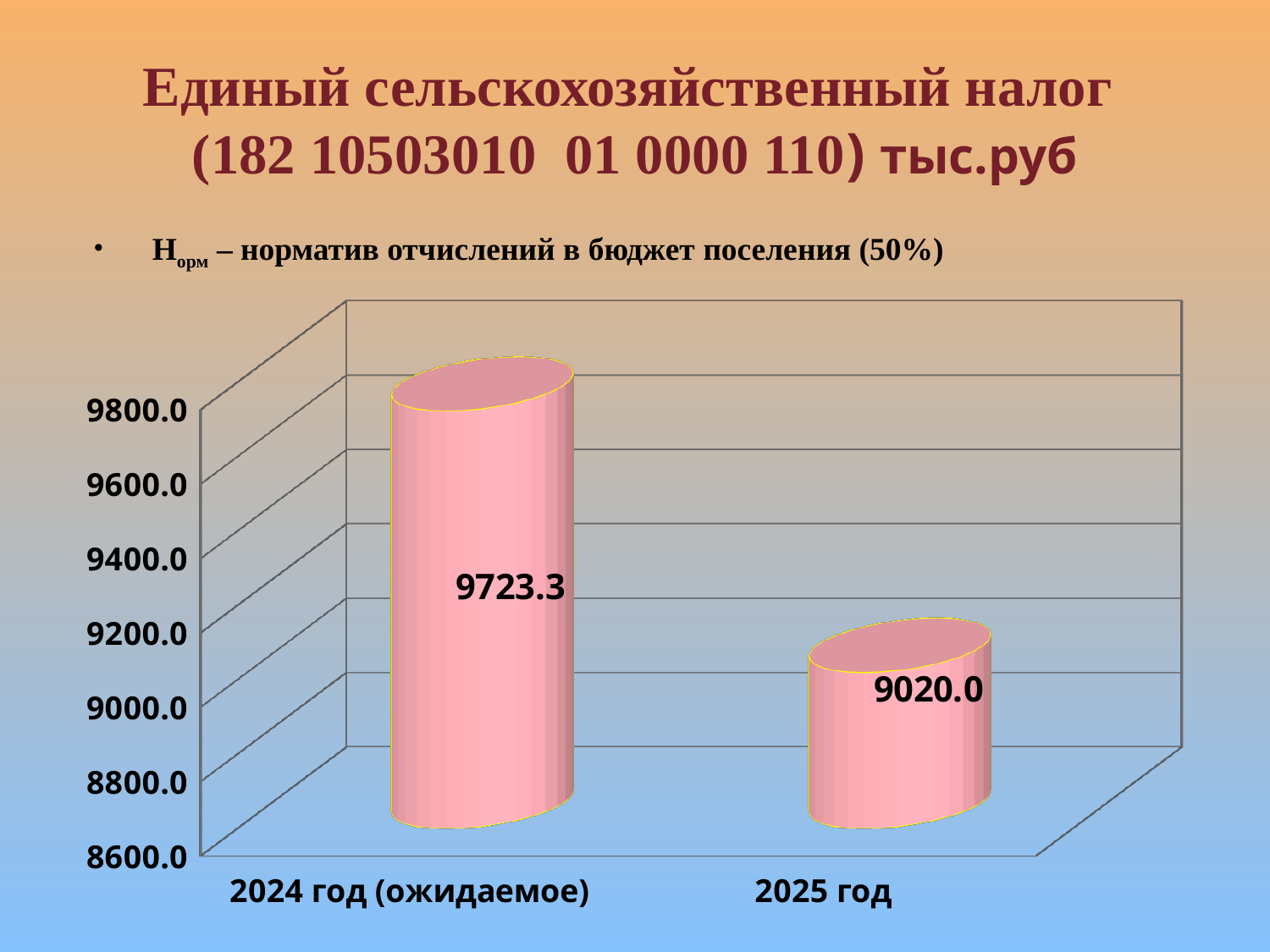
What is the unit of measurement stated in the slide title? тыс.руб What is the value for 2024 год (ожидаемое)? 9723.3 Is the value for 2024 год (ожидаемое) greater or less than 9600.0? greater What kind of chart is shown on the slide? bar chart Do the values rise or fall from 2024 год (ожидаемое) to 2025 год? fall Is the value for 2025 год greater or less than 9200.0? less What is the difference between the values for 2024 год (ожидаемое) and 2025 год? 703.3 Which is larger, the value for 2024 год (ожидаемое) or the value for 2025 год? 2024 год (ожидаемое) Which category has the highest value? 2024 год (ожидаемое) How many categories are shown on the chart? 2 Which category has the lowest value? 2025 год What is the value for 2025 год? 9020.0